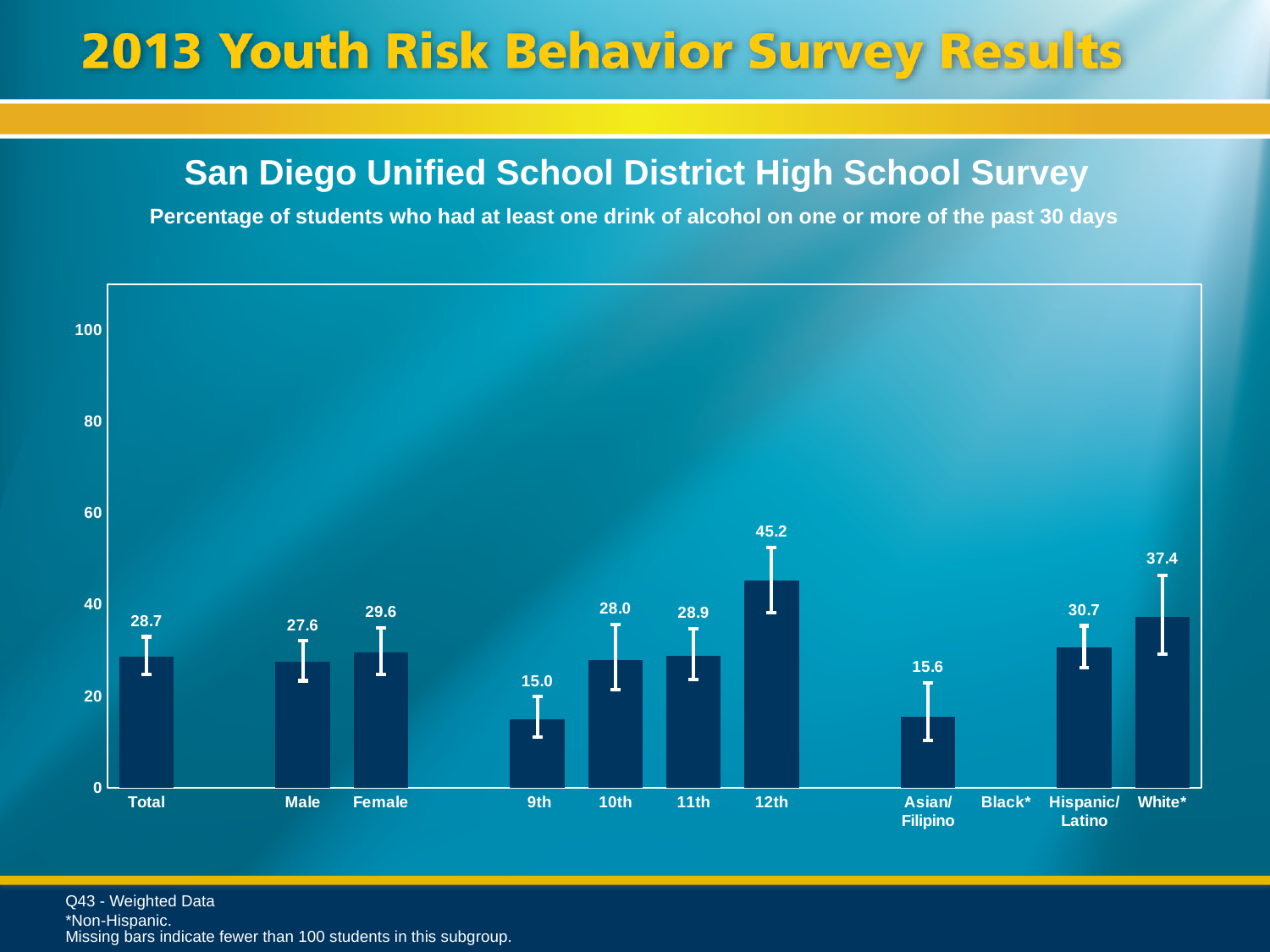
What is the value for Asian/Filipino? 15.6 Is the value for 12th grade greater or less than 40? greater Which category has the highest value? 12th How many bars are plotted on the chart? 10 What is the value for 12th grade? 45.2 What is the value for Total? 28.7 Which is larger, the value for White* or the value for Hispanic/Latino? White* Which category has no bar plotted? Black* What is the difference between the values for Female and Male? 2.0 Which category has the lowest plotted value? 9th Do the values rise or fall from 9th grade to 12th grade? rise What kind of chart is shown? bar chart